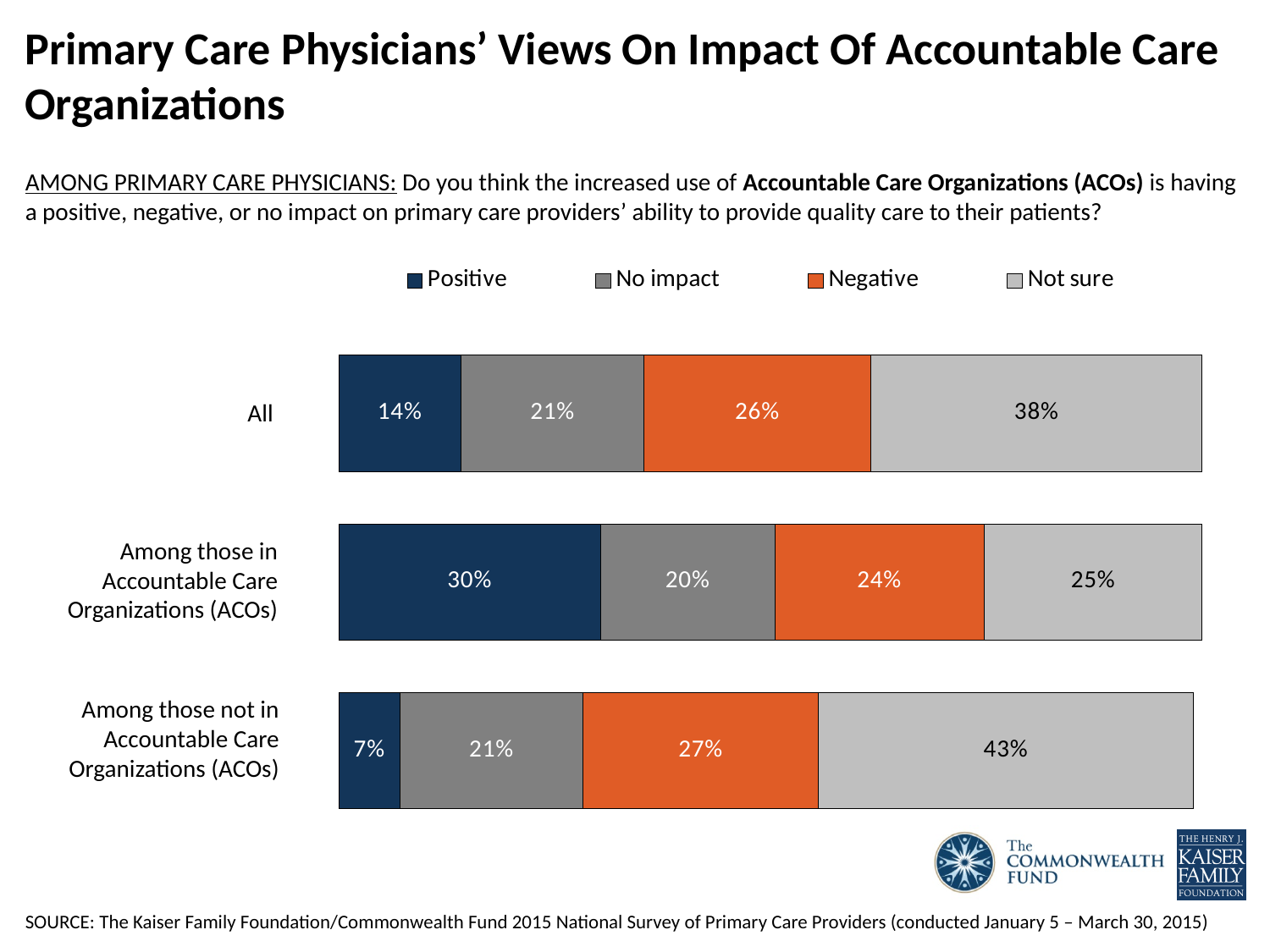
Is the 'Not sure' share larger for all physicians or for those in ACOs? All How many response categories does the legend list? 4 What is the difference between the positive share among those in ACOs and the positive share among those not in ACOs? 23 percentage points What percentage of all primary care physicians say ACOs are having a positive impact? 14% Which group has the lowest share saying ACOs have a positive impact? Among those not in Accountable Care Organizations (ACOs) What is the total of the 'Positive' and 'No impact' shares for all physicians? 35% What percentage of physicians in ACOs say ACOs are having a negative impact? 24% Which colour represents the 'Negative' response in the chart? Orange What percentage of physicians not in ACOs are not sure about the impact of ACOs? 43% What type of chart is shown on the slide? Stacked bar chart How many groups (bars) are shown in the chart? 3 Which group has the highest share saying ACOs have a positive impact? Among those in Accountable Care Organizations (ACOs)